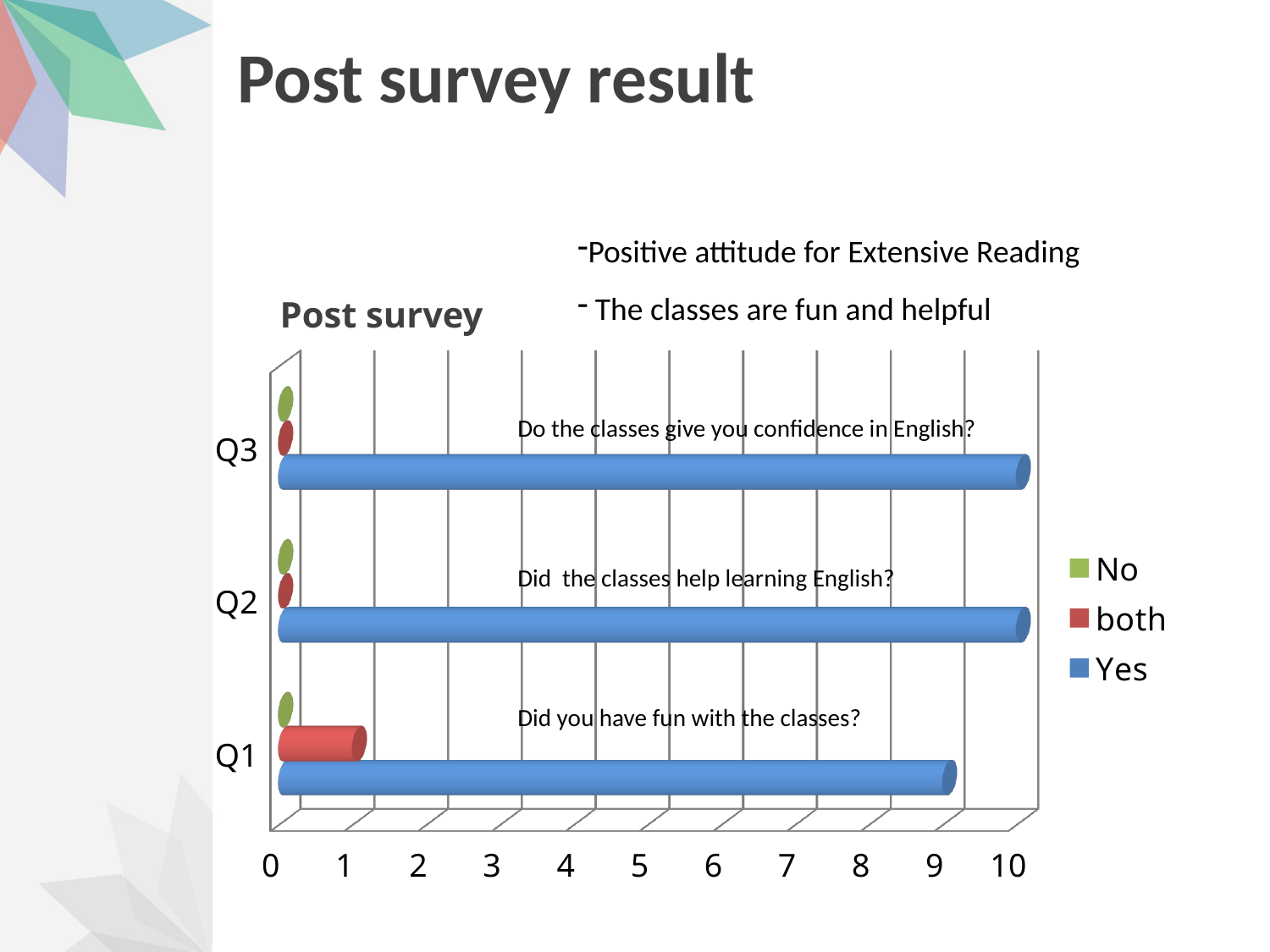
Which is larger: the 'Yes' value for Q1 or the 'Yes' value for Q2? Q2 Is the 'both' value for Q1 greater or less than 2? less Which question has the highest 'both' value? Q1 What kind of chart is shown on the slide? bar chart Which series is shown in blue in the legend? Yes For Q1, which is larger: the 'Yes' value or the 'both' value? Yes What is the title of the chart? Post survey How many question categories are shown on the chart's vertical axis? 3 How many series does the legend list? 3 Is the 'Yes' value for Q1 greater or less than 5? greater Is the 'Yes' value for Q3 greater or less than 8? greater Which question has the lowest 'Yes' value? Q1